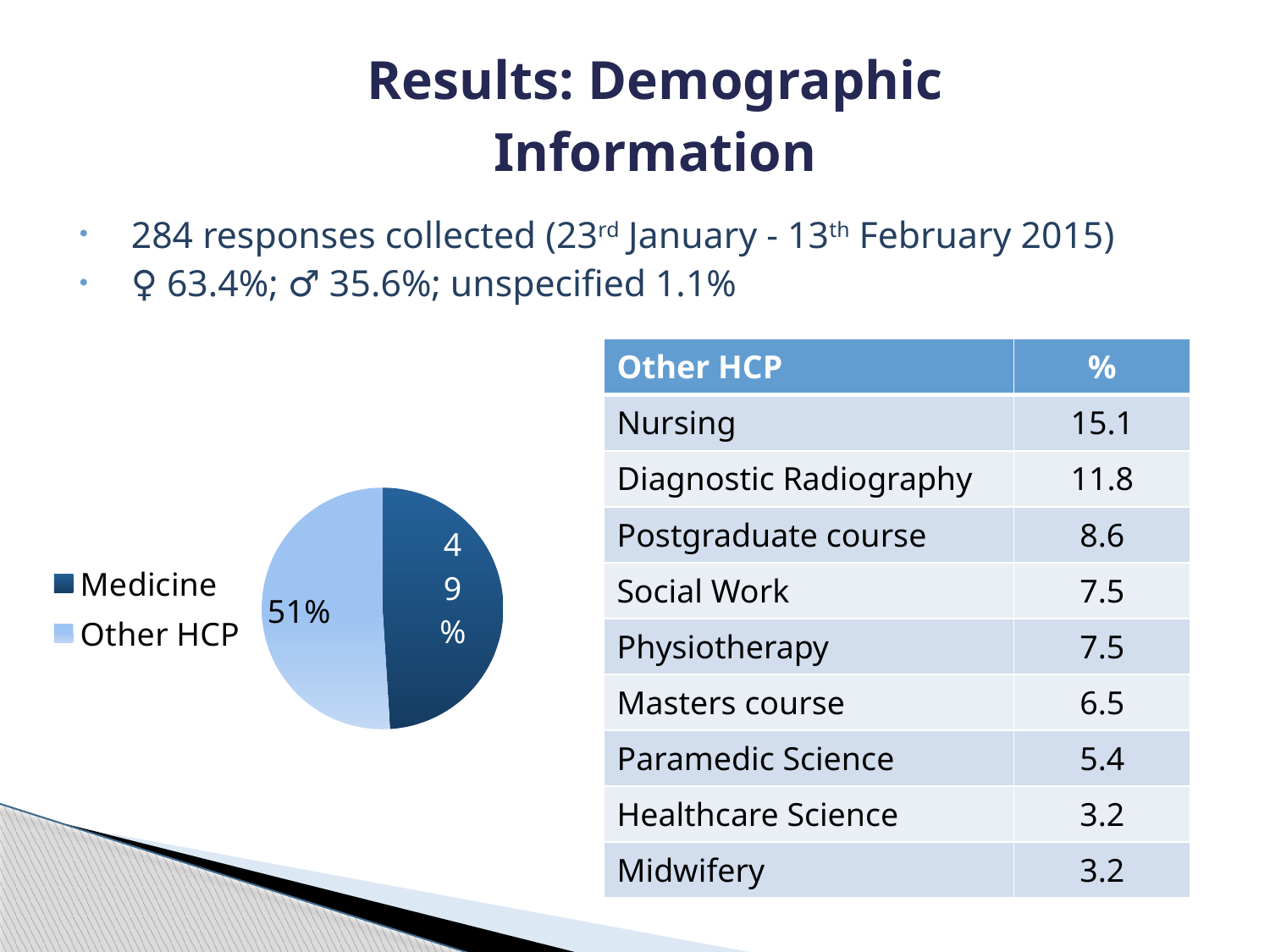
What do the two slices of the pie chart add up to? 100% Which slice of the pie chart is the largest? Other HCP How many entries does the pie chart's legend list? 2 What share of the pie chart does Medicine represent? 49% What kind of chart is shown on the slide? Pie chart Which slice of the pie chart is the smallest? Medicine What percentage does the pie chart show for Medicine? 49% Which colour represents Medicine in the pie chart? Dark blue What percentage does the pie chart show for Other HCP? 51% How many slices does the pie chart have? 2 By how many percentage points does Other HCP exceed Medicine in the pie chart? 2 Which is larger in the pie chart, Medicine or Other HCP? Other HCP